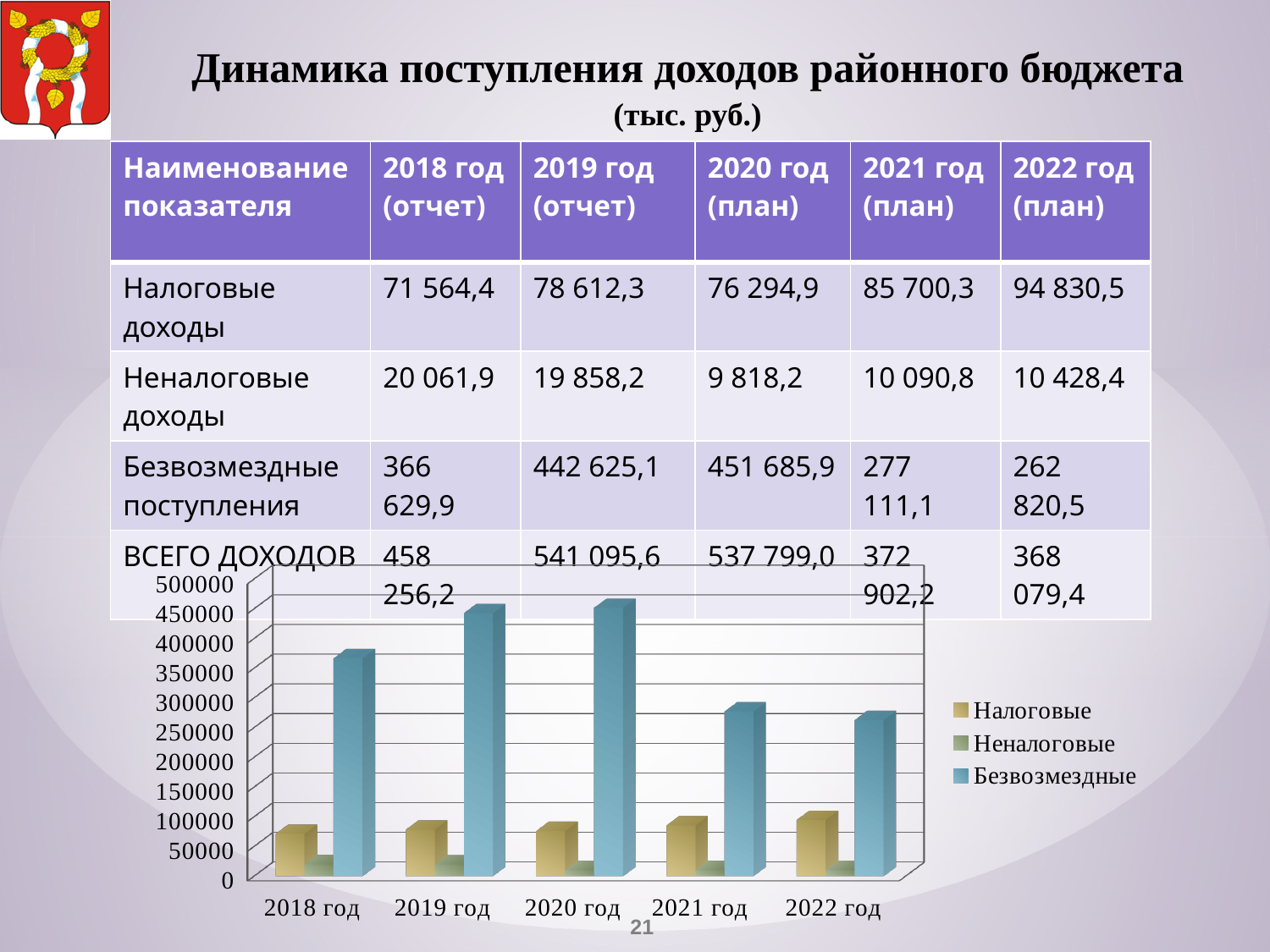
According to the table, what is the value of Налоговые доходы for 2022 год (план)? 94 830,5 How many year categories are shown on the x axis of the chart? 5 Is the value for Безвозмездные in 2021 год greater or less than 300000? less Do the Безвозмездные values rise or fall from 2020 год to 2022 год? fall Is the value for Неналоговые in 2018 год greater or less than 50000? less Which series has the tallest bars in every year of the chart? Безвозмездные How many series does the chart legend list? 3 What kind of chart is shown on the slide? bar chart Is the value for Безвозмездные in 2019 год greater or less than 400000? greater Which series is shown in blue in the chart? Безвозмездные Which is larger in the chart: Безвозмездные in 2019 год or Безвозмездные in 2021 год? 2019 год